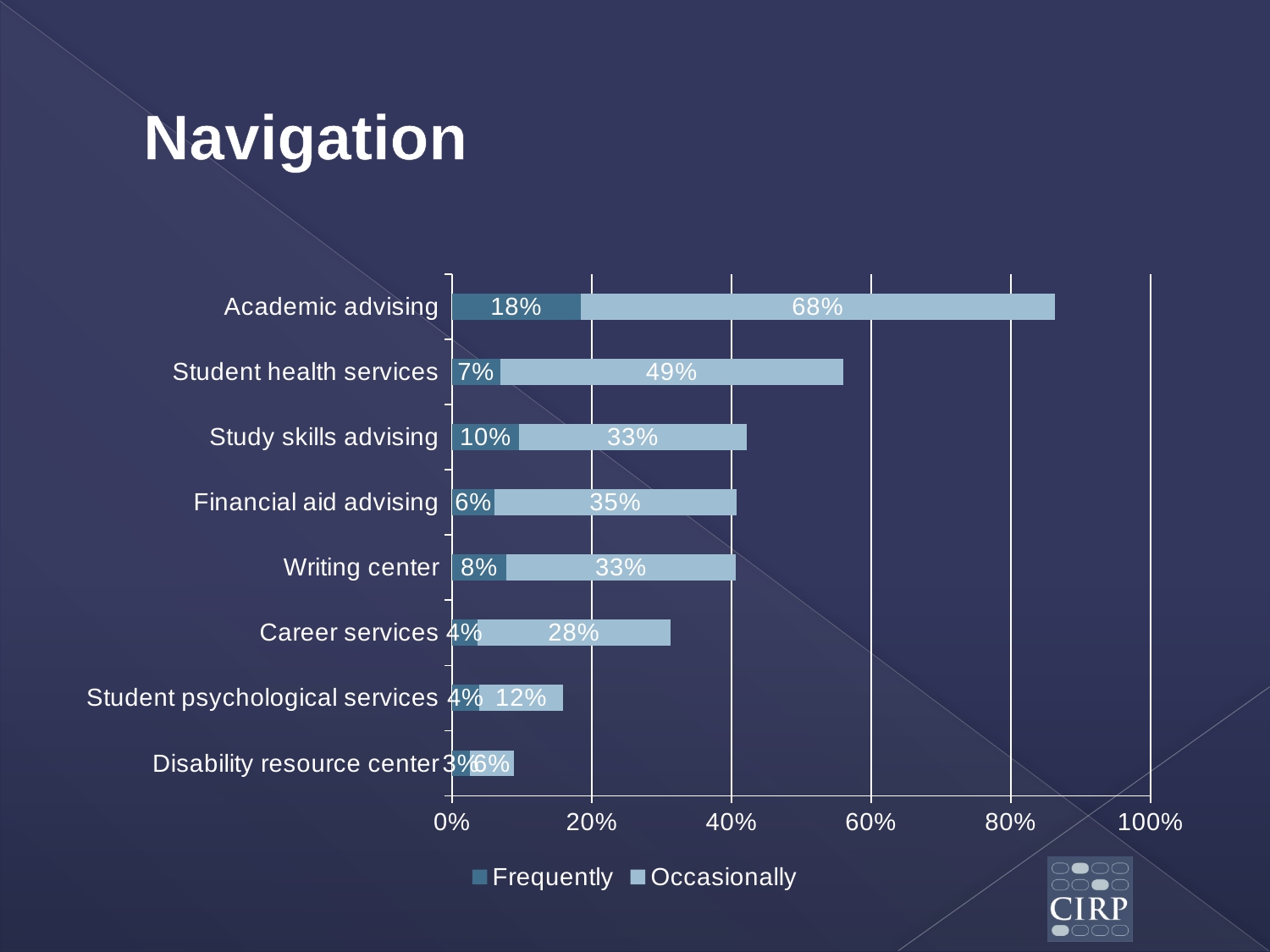
What is the Frequently value for Academic advising? 18% What is the difference between the Occasionally values for Academic advising and Student health services? 19% How many series does the legend list? 2 What is the Occasionally value for Career services? 28% How many categories are shown on the chart? 8 What is the Occasionally value for Student health services? 49% Which category has the lowest Frequently value? Disability resource center What is the total of the stacked bar for Financial aid advising? 41% Which category has the highest Occasionally value? Academic advising What kind of chart is shown on the slide? Stacked bar chart What is the title of the slide? Navigation Which is larger, the Frequently value for Study skills advising or the Frequently value for Writing center? Study skills advising